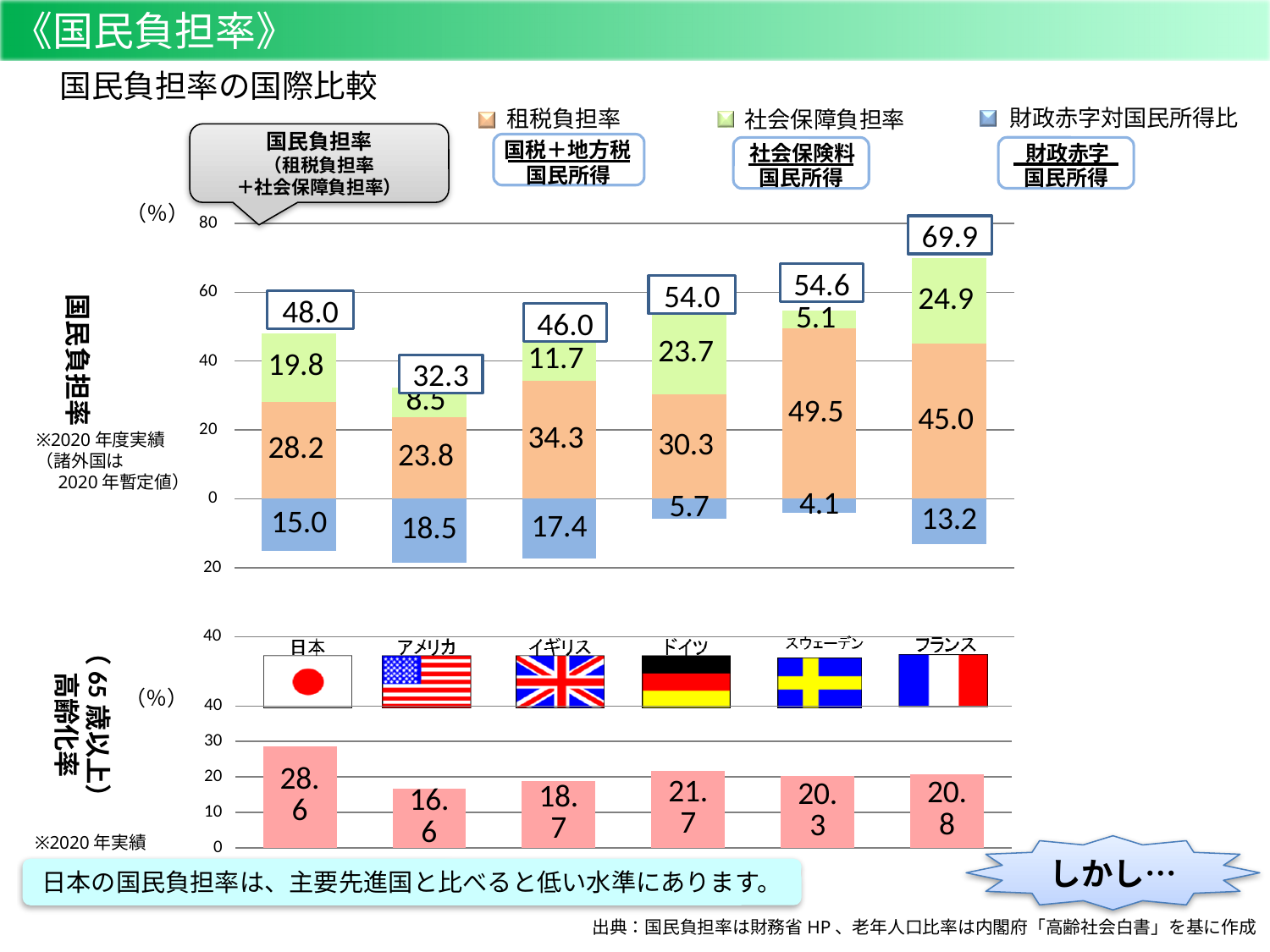
In the top chart (国民負担率の国際比較), what is the 租税負担率 value for 日本? 28.2 In the top chart (国民負担率の国際比較), what is the 社会保障負担率 value for フランス? 24.9 In the top chart (国民負担率の国際比較), which country has the lowest 国民負担率 total shown above its bar? アメリカ What kind of chart is the bottom chart (高齢化率)? bar chart How many countries are shown in the top chart (国民負担率の国際比較)? 6 In the top chart (国民負担率の国際比較), what is the difference between the 国民負担率 totals of フランス and 日本? 21.9 In the top chart (国民負担率の国際比較), what is the 財政赤字対国民所得比 value for アメリカ? 18.5 In the bottom chart (高齢化率), which country has the highest value? 日本 In the top chart (国民負担率の国際比較), which is larger, the 租税負担率 of スウェーデン or of イギリス? スウェーデン How many series does the legend of the top chart (国民負担率の国際比較) list? 3 In the bottom chart (高齢化率), what is the value for ドイツ? 21.7 In the top chart (国民負担率の国際比較), which country has the highest 国民負担率 total shown above its bar? フランス